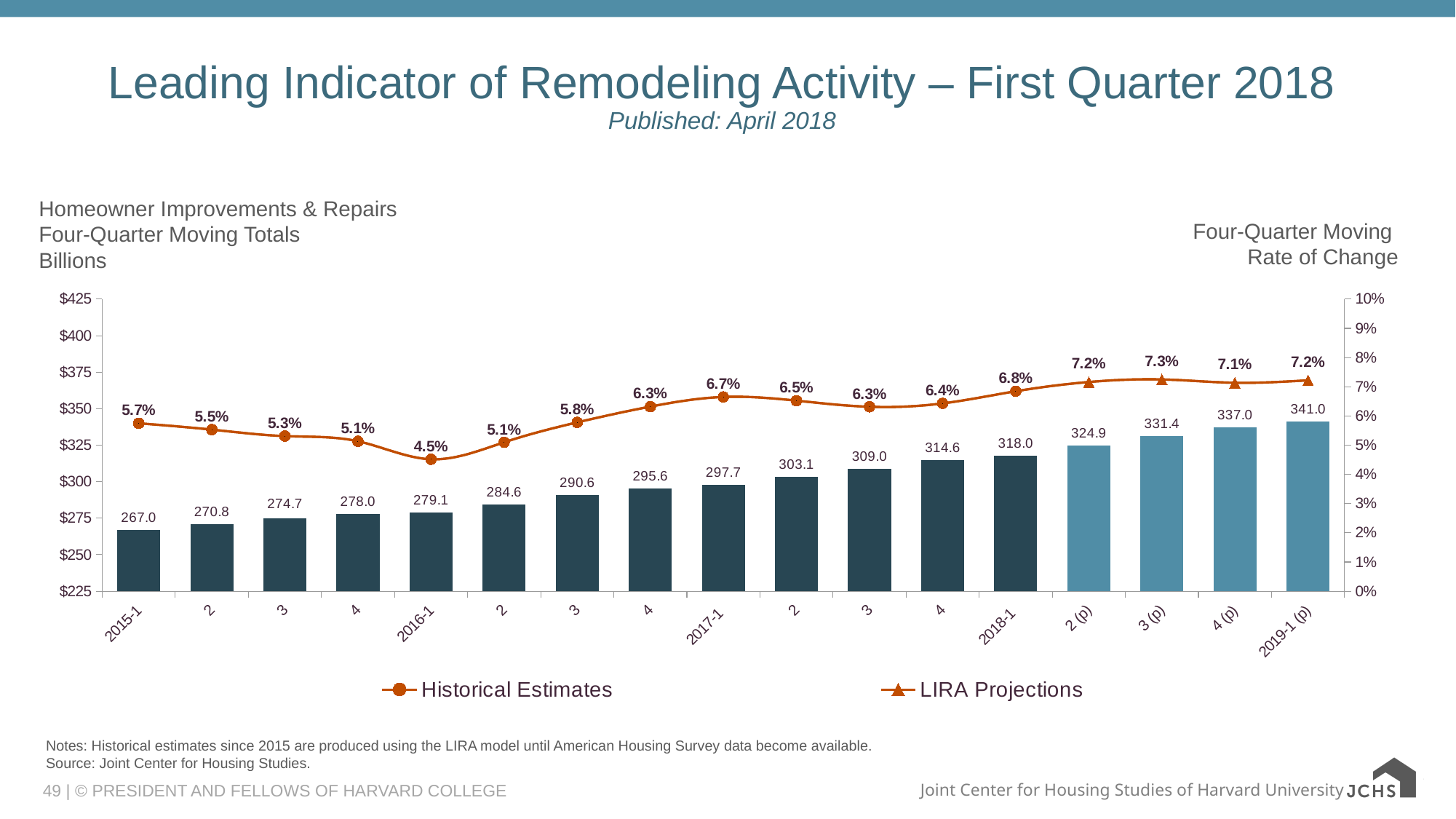
What is the four-quarter moving rate of change for 2016-1? 4.5% What is the difference between the four-quarter moving totals for 2019-1 (p) and 2018-1? 23.0 What is the projected four-quarter moving total for 2019-1 (p)? 341.0 Which quarter has the highest four-quarter moving total? 2019-1 (p) Which quarter has the lowest four-quarter moving rate of change? 2016-1 What are the two entries in the chart legend? Historical Estimates and LIRA Projections What kind of chart is shown on the slide? Combined bar and line chart What is the four-quarter moving total for 2017-1? 297.7 How many quarters are shown on the x axis? 17 How many series does the legend list? 2 Do the four-quarter moving totals rise or fall from 2015-1 to 2019-1 (p)? Rise Which has a higher rate of change, 2016-1 or 2017-1? 2017-1